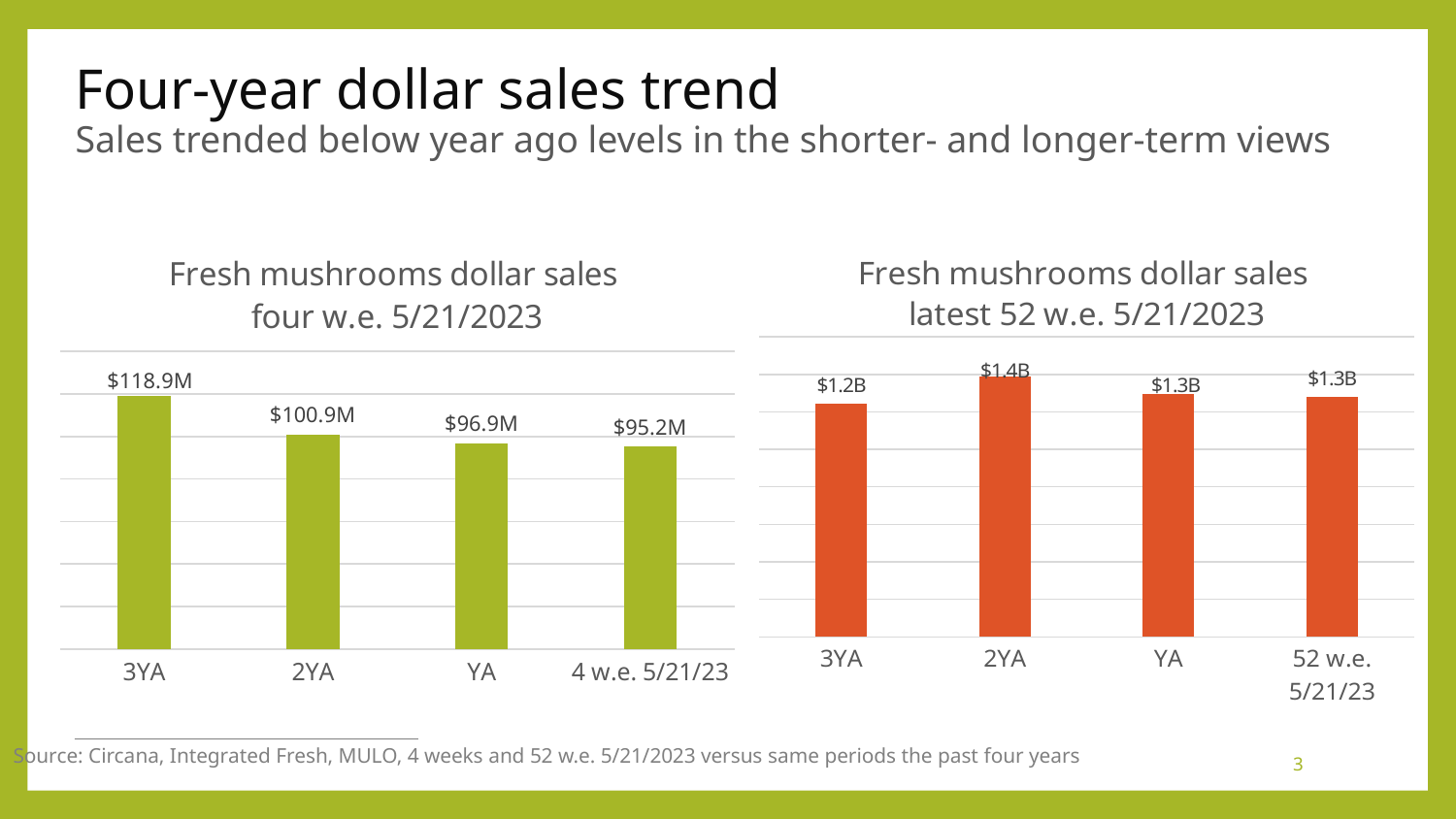
In the 'Fresh mushrooms dollar sales four w.e. 5/21/2023' chart, what is the value for 4 w.e. 5/21/23? $95.2M In the 'Fresh mushrooms dollar sales latest 52 w.e. 5/21/2023' chart, what is the value for 3YA? $1.2B In the 'Fresh mushrooms dollar sales four w.e. 5/21/2023' chart, what is the difference between the 3YA value and the 4 w.e. 5/21/23 value? $23.7M In the 'Fresh mushrooms dollar sales four w.e. 5/21/2023' chart, which category has the lowest value? 4 w.e. 5/21/23 In the 'Fresh mushrooms dollar sales latest 52 w.e. 5/21/2023' chart, which is larger, the value for 3YA or the value for 2YA? 2YA In the 'Fresh mushrooms dollar sales latest 52 w.e. 5/21/2023' chart, which category has the highest value? 2YA In the 'Fresh mushrooms dollar sales four w.e. 5/21/2023' chart, do the values rise or fall from 3YA to 4 w.e. 5/21/23? fall In the 'Fresh mushrooms dollar sales four w.e. 5/21/2023' chart, which category has the highest value? 3YA What type of chart is the 'Fresh mushrooms dollar sales four w.e. 5/21/2023' chart? bar chart How many bars are in the 'Fresh mushrooms dollar sales latest 52 w.e. 5/21/2023' chart? 4 In the 'Fresh mushrooms dollar sales latest 52 w.e. 5/21/2023' chart, what is the value for 2YA? $1.4B In the 'Fresh mushrooms dollar sales four w.e. 5/21/2023' chart, what is the value for 3YA? $118.9M